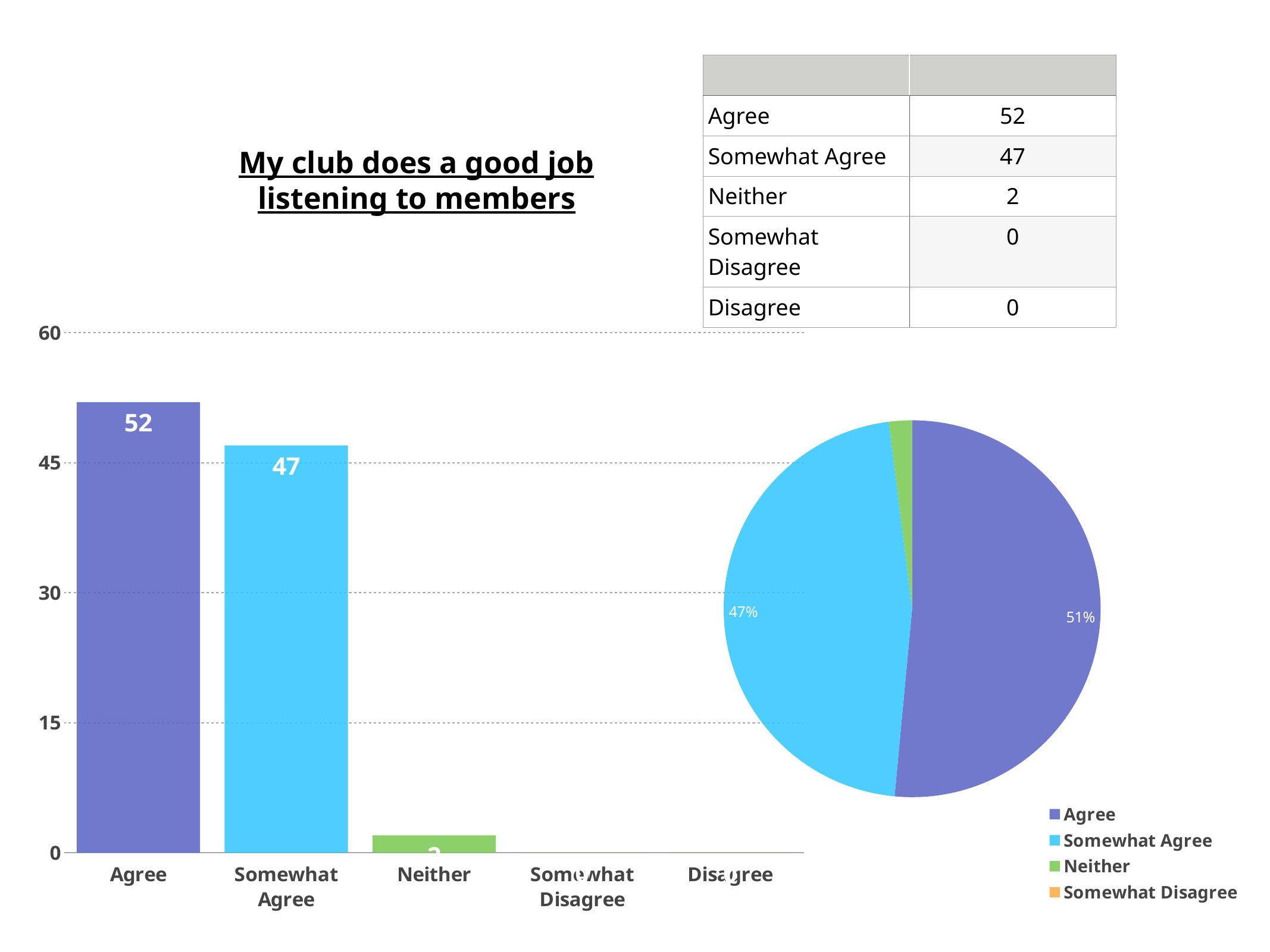
In the bar chart, what is the difference between the values for Agree and Somewhat Agree? 5 What is the title shown above the bar chart? My club does a good job listening to members In the bar chart, what is the value for Somewhat Agree? 47 In the bar chart, which is larger, the value for Somewhat Agree or the value for Neither? Somewhat Agree In the pie chart, what share does the Agree slice have? 51% What kind of chart is the chart on the left of the slide? bar chart How many entries does the legend of the pie chart list? 4 In the bar chart, is the value for Somewhat Agree greater or less than 30? greater How many categories are shown on the x axis of the bar chart? 5 In the bar chart, which category has the highest value? Agree In the bar chart, what is the value for Agree? 52 In the pie chart, what share does the Somewhat Agree slice have? 47%